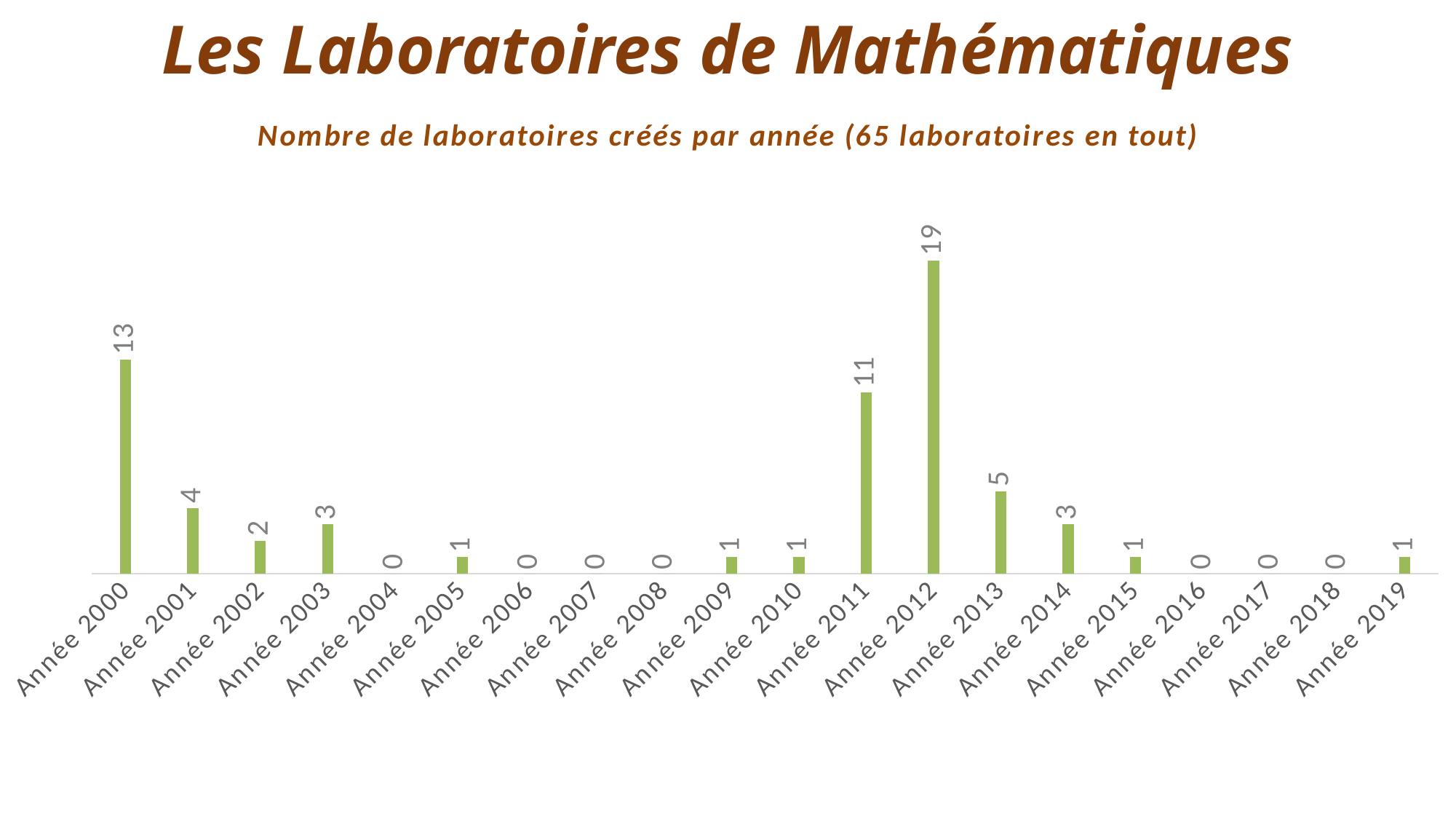
How many years have a value of 0? 7 How many laboratories were created in Année 2013? 5 Which year has the highest number of laboratories created? Année 2012 Which is larger, the value for Année 2003 or the value for Année 2014? They are equal (3) What is the value shown for Année 2000? 13 How many laboratories were created in Année 2012? 19 Which is larger, the value for Année 2000 or the value for Année 2011? Année 2000 What kind of chart is shown on the slide? Bar chart What is the difference between the values for Année 2012 and Année 2011? 8 What is the difference between the values for Année 2000 and Année 2001? 9 What is the subtitle of the chart? Nombre de laboratoires créés par année (65 laboratoires en tout) How many years (categories) are shown on the x axis? 20